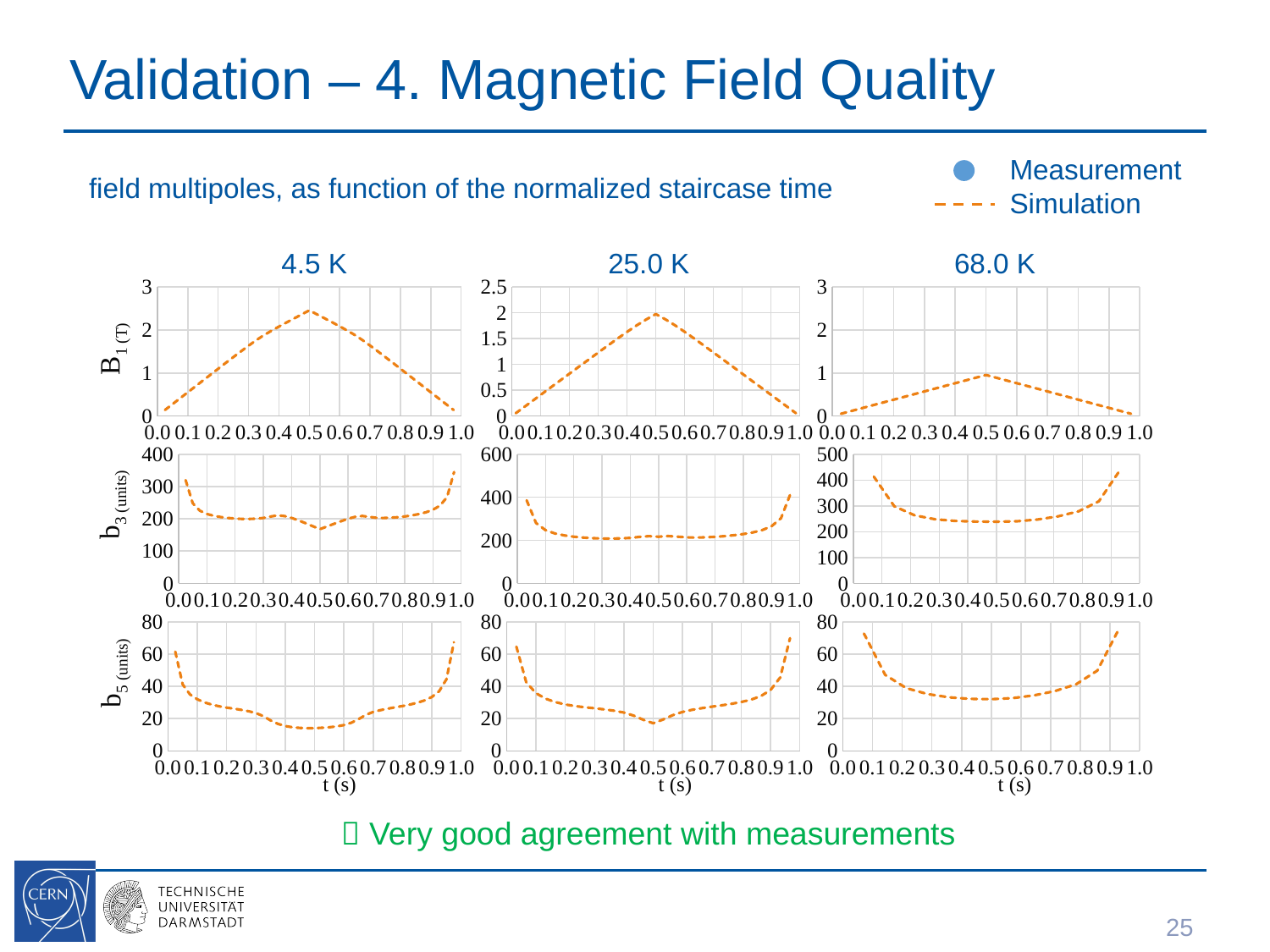
In the B1 chart for 68.0 K, is the value at t = 0.5 greater or less than 2? less In the b5 chart for 4.5 K, is the value at t = 0.5 greater or less than 20? less In the b3 chart for 68.0 K, is the value at t = 0.5 greater or less than 300? less What are the three temperatures labelled above the columns of charts? 4.5 K, 25.0 K, 68.0 K How many series does the legend list? 2 What kind of chart is the B1 chart for 4.5 K? line chart In the B1 chart for 4.5 K, does the value rise or fall between t = 0.0 and t = 0.5? rise In the B1 chart for 25.0 K, does the value rise or fall between t = 0.5 and t = 1.0? fall